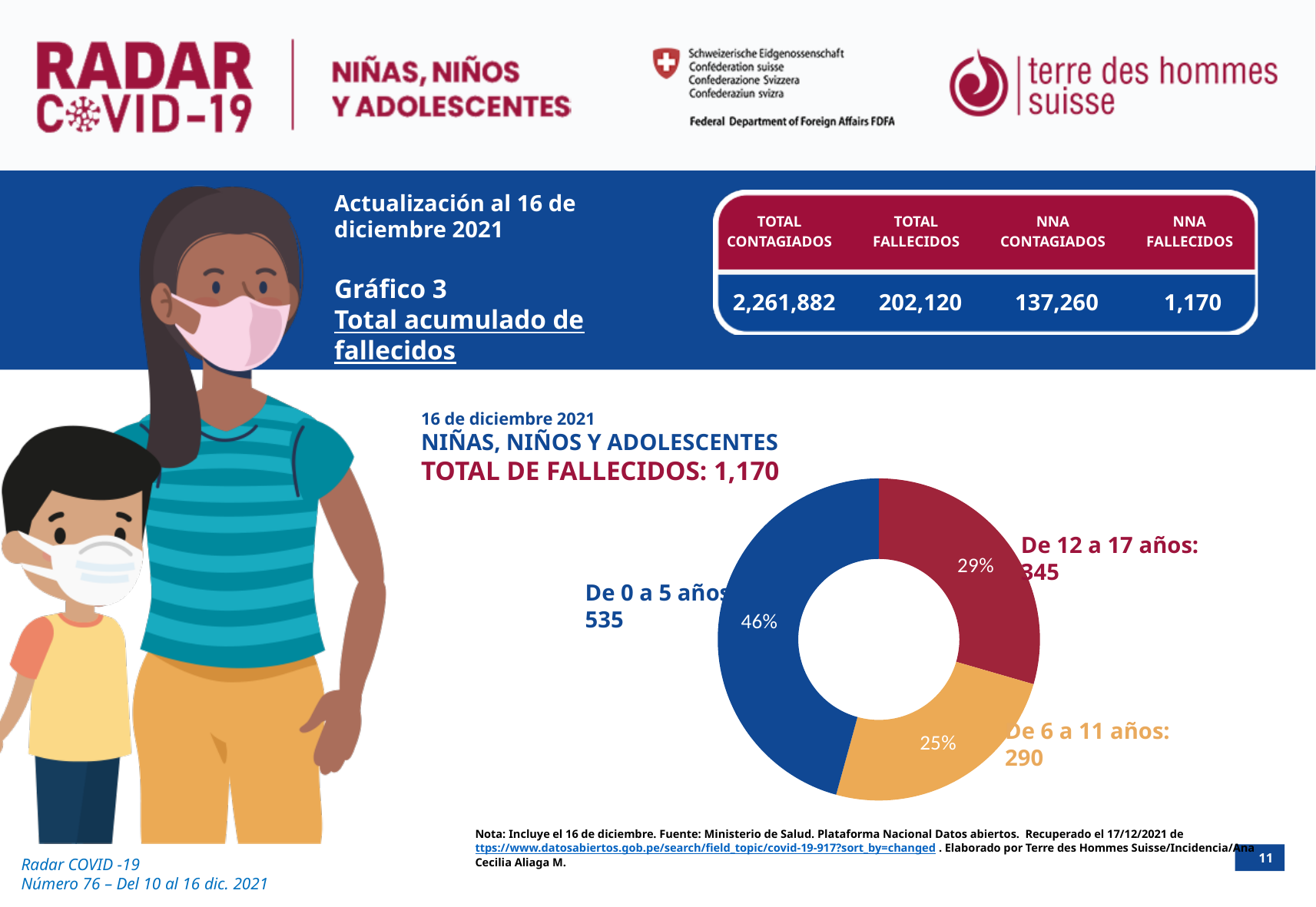
What is the number of fallecidos for De 0 a 5 años? 535 How many age groups are shown in the chart? 3 What share of the chart does De 12 a 17 años represent? 29% What share of the chart does De 0 a 5 años represent? 46% What kind of chart is shown on the slide? donut chart Which age group has the smallest slice in the chart? De 6 a 11 años What total de fallecidos is stated in the chart heading? 1,170 Which age group has the largest slice in the chart? De 0 a 5 años What is the number of fallecidos for De 6 a 11 años? 290 Which is larger, the slice for De 12 a 17 años or the slice for De 6 a 11 años? De 12 a 17 años What share of the chart does De 6 a 11 años represent? 25% What is the difference between the values for De 0 a 5 años and De 6 a 11 años? 245